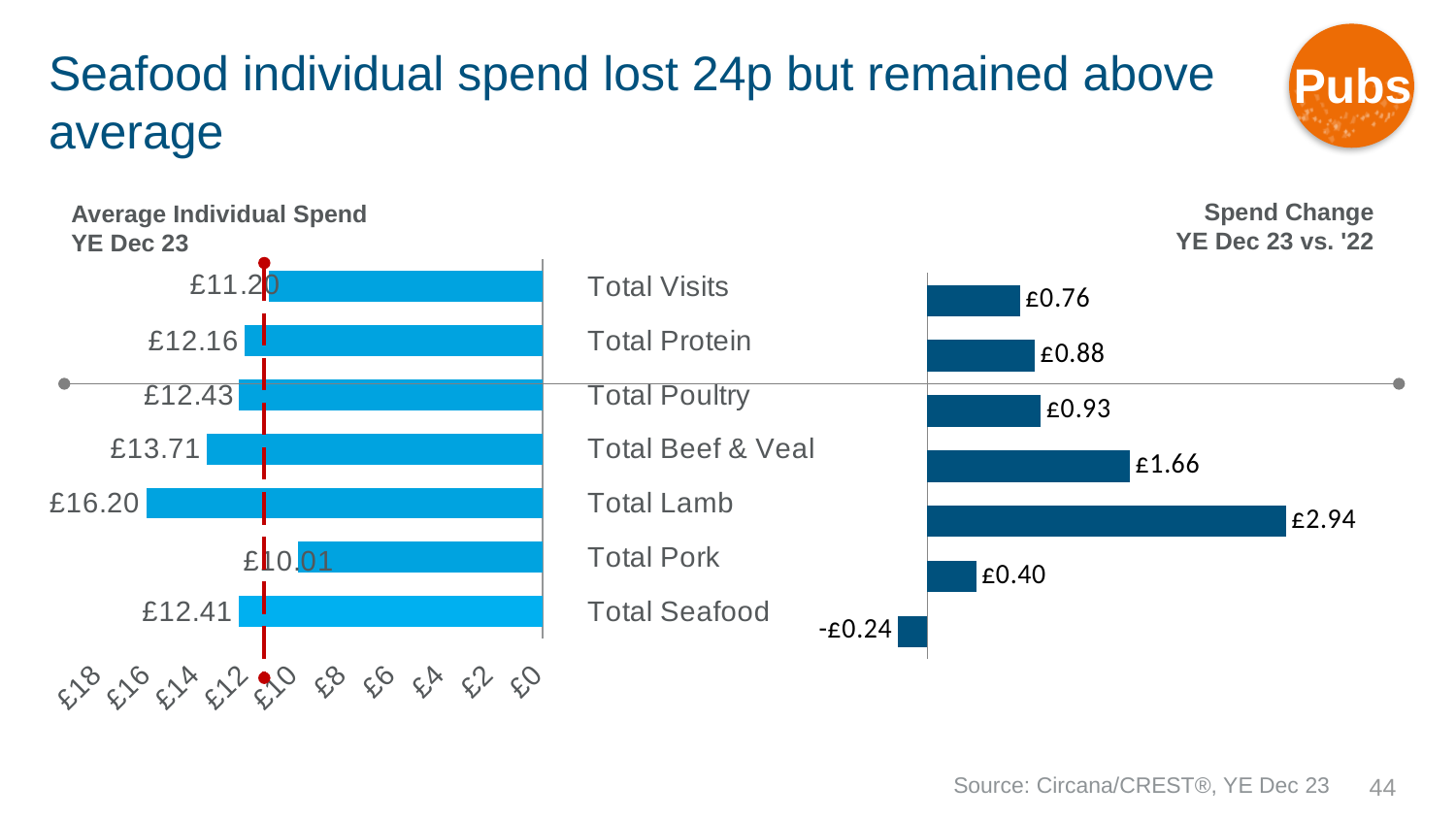
What kind of chart is the Spend Change YE Dec 23 vs. '22 chart? Bar chart In the Spend Change YE Dec 23 vs. '22 chart, what is the difference between Total Lamb and Total Pork? £2.54 In the Spend Change YE Dec 23 vs. '22 chart, what is the value for Total Seafood? -£0.24 In the Average Individual Spend YE Dec 23 chart, what is the value for Total Seafood? £12.41 In the Average Individual Spend YE Dec 23 chart, which category has the lowest value? Total Pork How many categories are shown in the Average Individual Spend YE Dec 23 chart? 7 In the Average Individual Spend YE Dec 23 chart, what is the difference between Total Lamb and Total Visits? £5.00 In the Spend Change YE Dec 23 vs. '22 chart, what is the value for Total Beef & Veal? £1.66 In the Average Individual Spend YE Dec 23 chart, which is larger, Total Beef & Veal or Total Poultry? Total Beef & Veal In the Spend Change YE Dec 23 vs. '22 chart, which category has the highest value? Total Lamb In the Average Individual Spend YE Dec 23 chart, what is the value for Total Lamb? £16.20 In the Spend Change YE Dec 23 vs. '22 chart, which category has the lowest value? Total Seafood